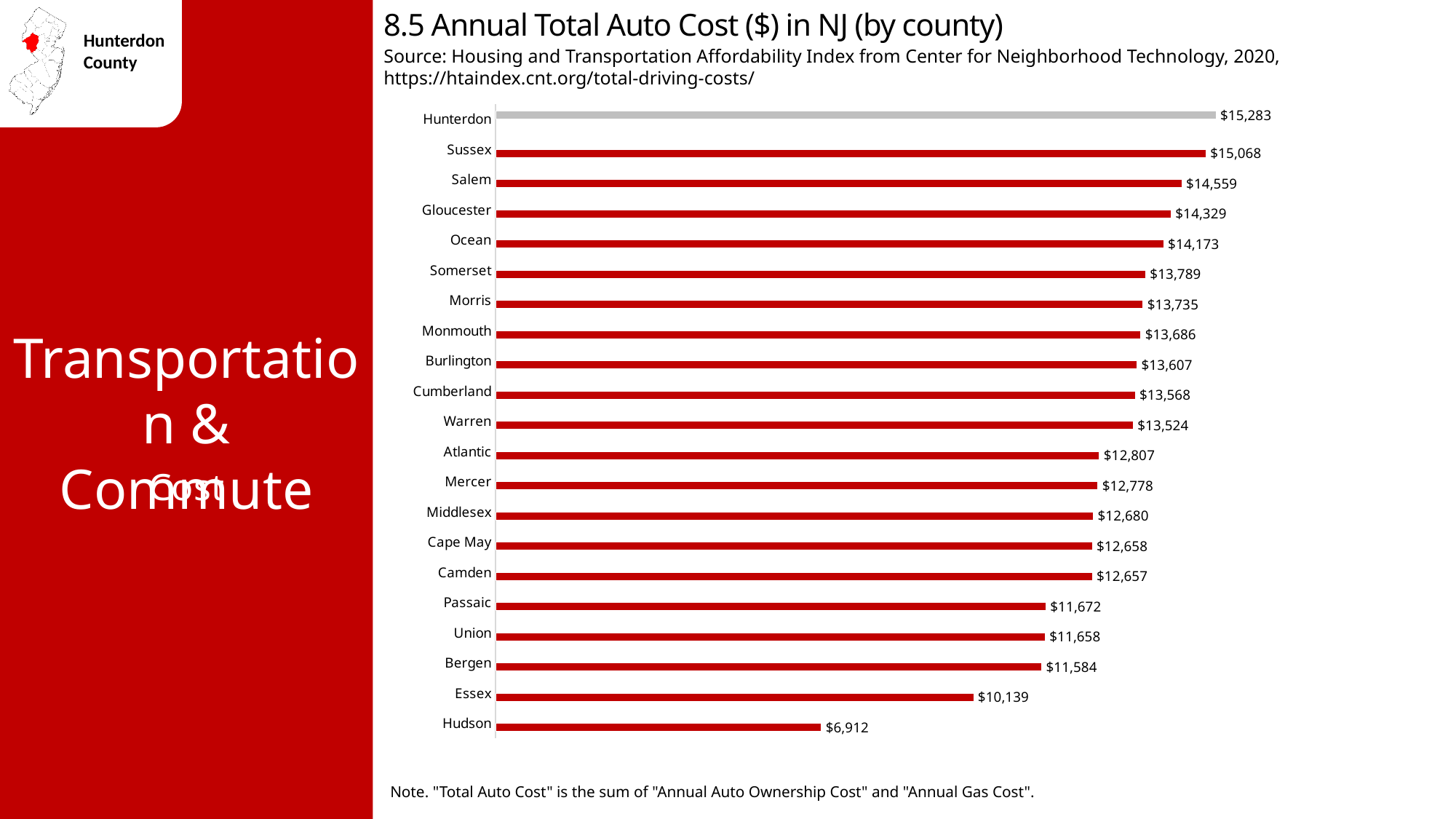
Which county has a higher annual total auto cost, Bergen or Essex? Bergen Which county has the highest annual total auto cost? Hunterdon Which county has a higher annual total auto cost, Ocean or Passaic? Ocean Which county's bar is shown in a different colour (grey) from the others? Hunterdon Which county has the lowest annual total auto cost? Hudson What type of chart is used to show annual total auto cost by county? Bar chart How many counties are shown in the chart? 21 What is the difference in annual total auto cost between Hunterdon and Hudson counties? $8,371 What is the annual total auto cost for Essex County? $10,139 What is the annual total auto cost for Hunterdon County? $15,283 What is the annual total auto cost for Mercer County? $12,778 What is the difference in annual total auto cost between Sussex and Salem counties? $509